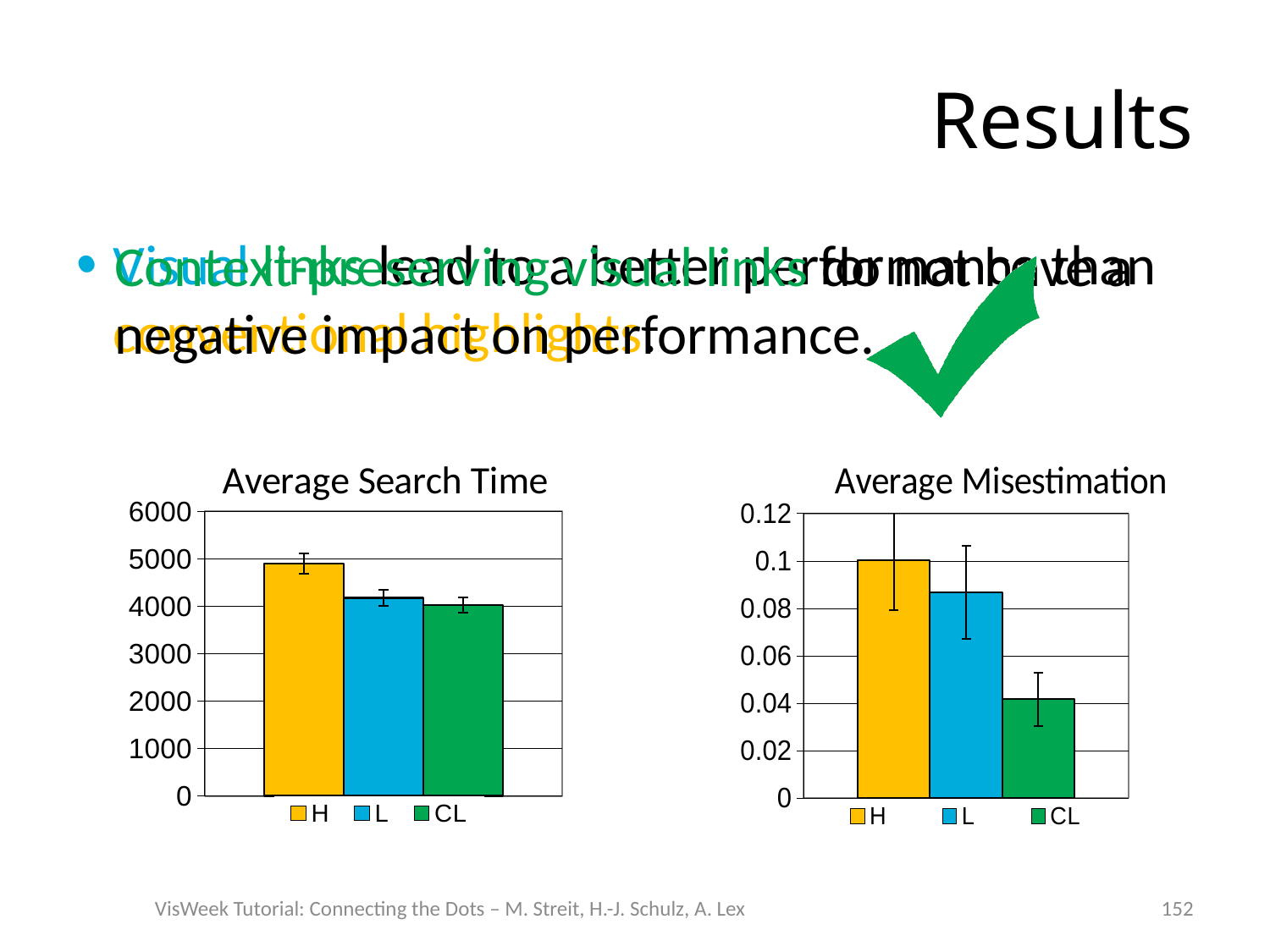
In the Average Search Time chart, which series has the highest value? H In the Average Search Time chart, which is larger, the value for H or the value for CL? H In the Average Misestimation chart, which series has the lowest value? CL In the Average Misestimation chart, is the value for CL greater or less than 0.06? less What colour is the CL bar in the Average Search Time chart? green What kind of chart is the Average Search Time chart? bar chart In the Average Search Time chart, is the value for L greater or less than 5000? less In the Average Misestimation chart, is the value for L greater or less than 0.06? greater In the Average Misestimation chart, which is larger, the value for L or the value for CL? L In the Average Misestimation chart, which series has the highest value? H How many series does the legend of the Average Misestimation chart list? 3